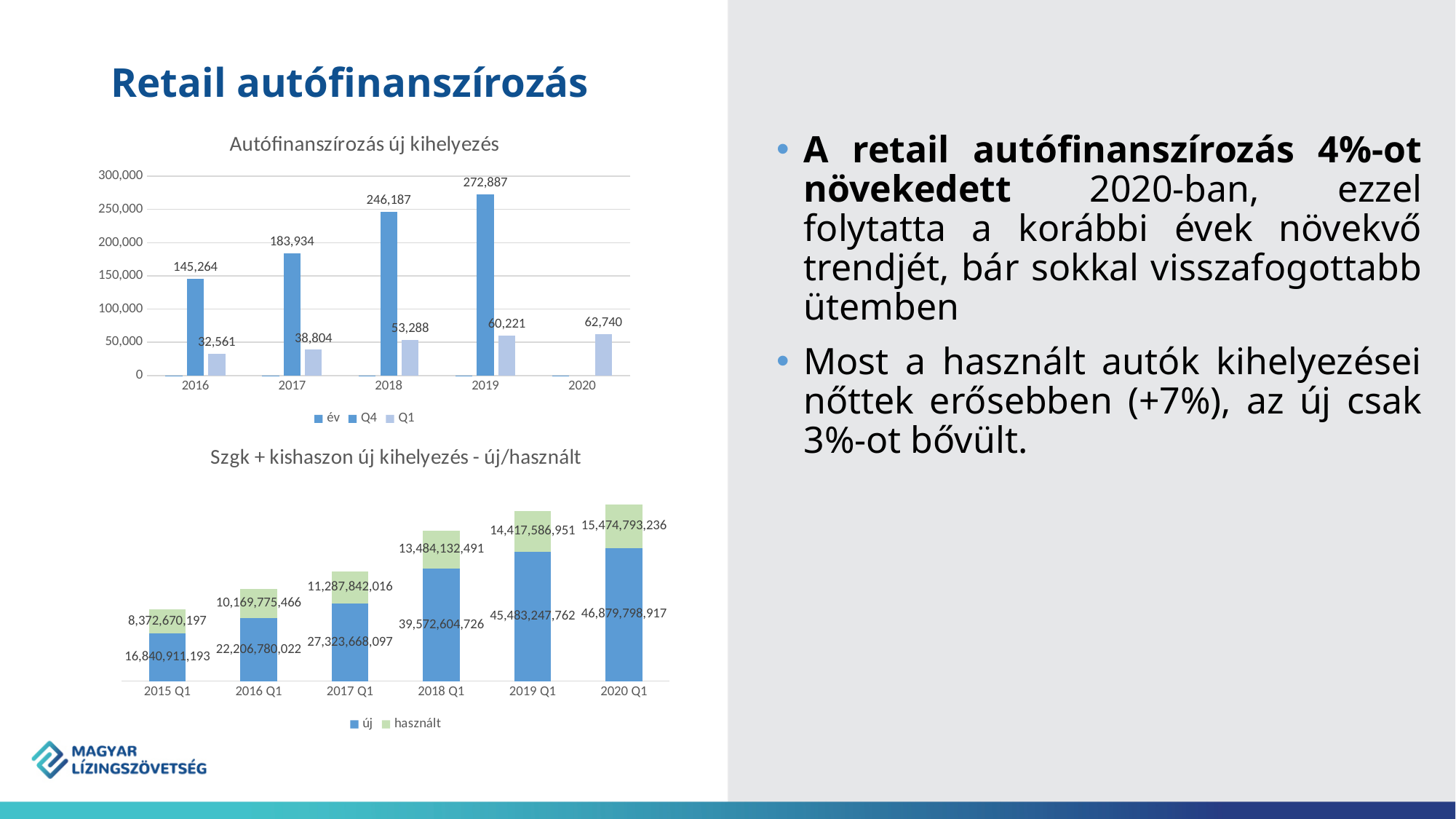
What kind of chart is 'Szgk + kishaszon új kihelyezés - új/használt'? stacked bar chart In the chart 'Autófinanszírozás új kihelyezés', what is the Q1 value for 2020? 62,740 In the chart 'Autófinanszírozás új kihelyezés', what is the Q4 value for 2018? 246,187 In the chart 'Szgk + kishaszon új kihelyezés - új/használt', what is the 'használt' value for 2017 Q1? 11,287,842,016 In the chart 'Szgk + kishaszon új kihelyezés - új/használt', which is larger: the 'új' value for 2019 Q1 or the 'új' value for 2017 Q1? 2019 Q1 In the chart 'Autófinanszírozás új kihelyezés', do the Q1 values rise or fall from 2016 to 2020? rise In the chart 'Autófinanszírozás új kihelyezés', how many series does the legend list? 3 In the chart 'Szgk + kishaszon új kihelyezés - új/használt', what is the 'új' value for 2018 Q1? 39,572,604,726 In the chart 'Autófinanszírozás új kihelyezés', what is the difference between the Q4 values for 2019 and 2018? 26,700 In the chart 'Szgk + kishaszon új kihelyezés - új/használt', what is the total of the stacked bar for 2020 Q1? 62,354,592,153 In the chart 'Szgk + kishaszon új kihelyezés - új/használt', how many categories are shown on the x axis? 6 In the chart 'Autófinanszírozás új kihelyezés', which year has the highest Q4 value? 2019